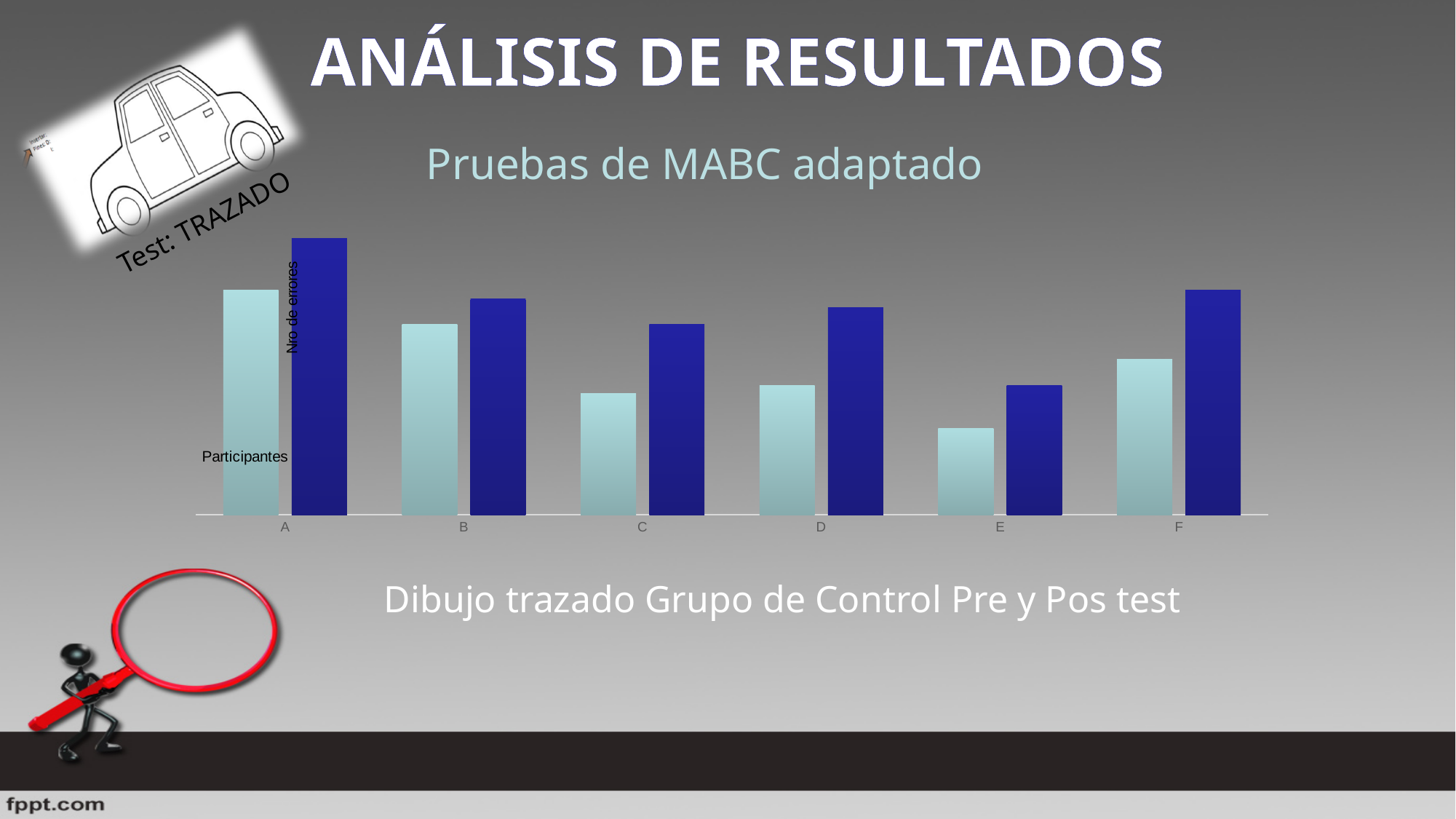
For participant F, which bar is taller, the light blue bar or the dark blue bar? dark blue bar Which is taller, the light blue bar for participant B or the light blue bar for participant F? participant B What kind of chart is shown on the slide? bar chart How many participant categories are shown on the x axis of the chart? 6 Which participant has the tallest dark blue bar in the chart? A Which participant has the shortest dark blue bar in the chart? E Which is taller, the dark blue bar for participant A or the dark blue bar for participant C? participant A What is the title of the horizontal axis of the chart? Participantes What is the title of the vertical axis of the chart? Nro de errores How many bars are plotted for each participant category in the chart? 2 Which participant has the shortest light blue bar in the chart? E Which participant has the tallest light blue bar in the chart? A